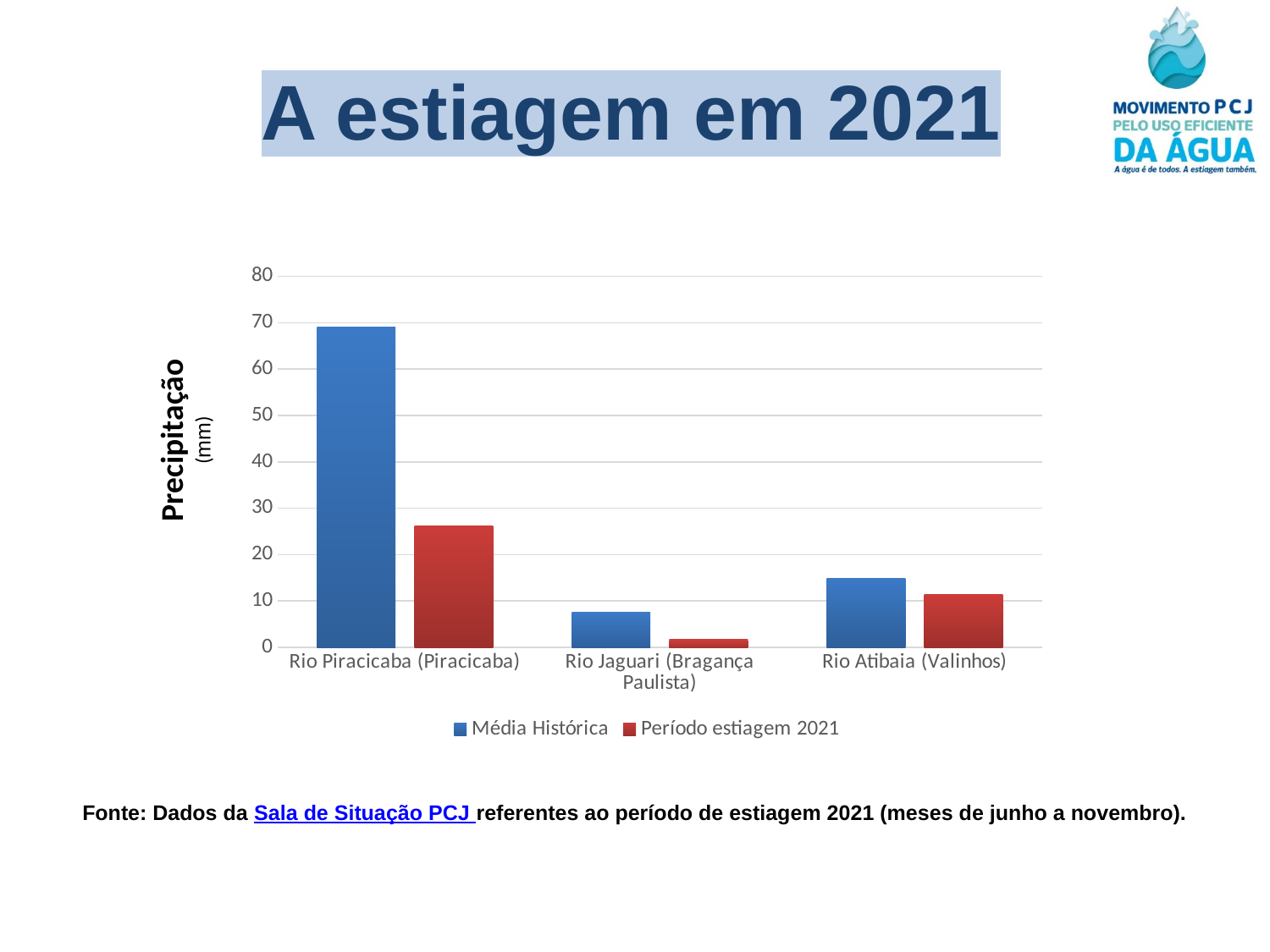
Which colour represents the Período estiagem 2021 series in the chart? red How many series does the chart legend list? 2 Which river has the lowest Período estiagem 2021 value? Rio Jaguari (Bragança Paulista) Is the Período estiagem 2021 value for Rio Piracicaba (Piracicaba) greater or less than 30? less Is the Média Histórica value for Rio Piracicaba (Piracicaba) greater or less than 60? greater For Rio Piracicaba (Piracicaba), which is larger: Média Histórica or Período estiagem 2021? Média Histórica What is the label of the y axis of the chart? Precipitação (mm) Which river has the highest Média Histórica value? Rio Piracicaba (Piracicaba) Is the Média Histórica value for Rio Jaguari (Bragança Paulista) greater or less than 10? less Which river has a larger Média Histórica value: Rio Atibaia (Valinhos) or Rio Jaguari (Bragança Paulista)? Rio Atibaia (Valinhos) How many river categories are shown on the x axis of the chart? 3 What kind of chart is shown on the slide? bar chart